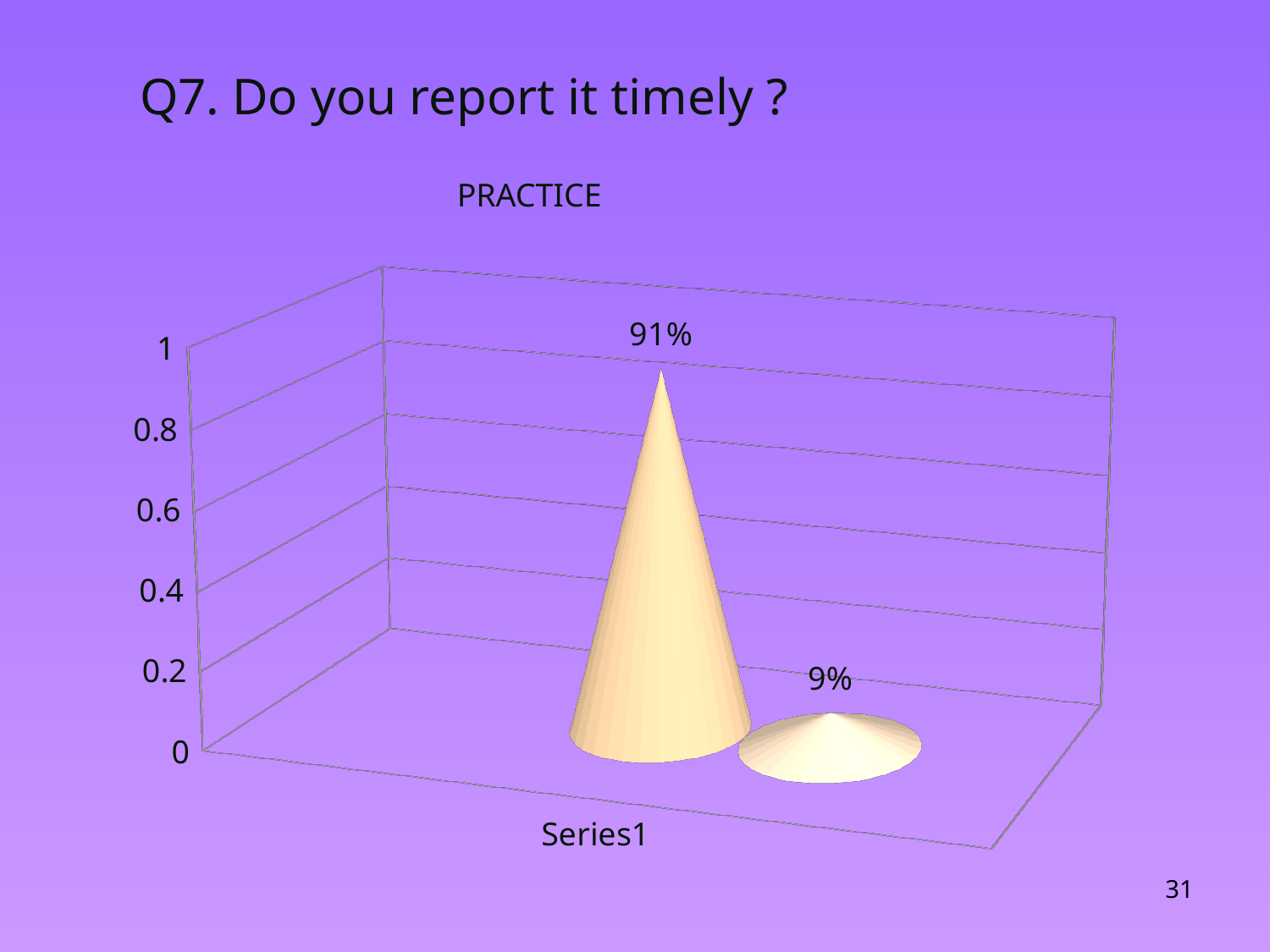
What is the difference between the two values shown in the chart? 82 percentage points Is the value of the shorter cone greater or less than 0.2 on the vertical axis? less What value is labelled on the taller cone in the chart? 91% What value is labelled on the shorter cone on the right of the chart? 9% Is the left cone's value larger or smaller than the right cone's value? larger Is the value of the taller cone greater or less than 0.8 on the vertical axis? greater What is the total of the two values shown in the chart? 100% What kind of chart is shown on the slide? bar chart What is the title of the chart? PRACTICE What is the highest value shown in the chart? 91% How many data points are plotted in the chart? 2 What is the lowest value shown in the chart? 9%